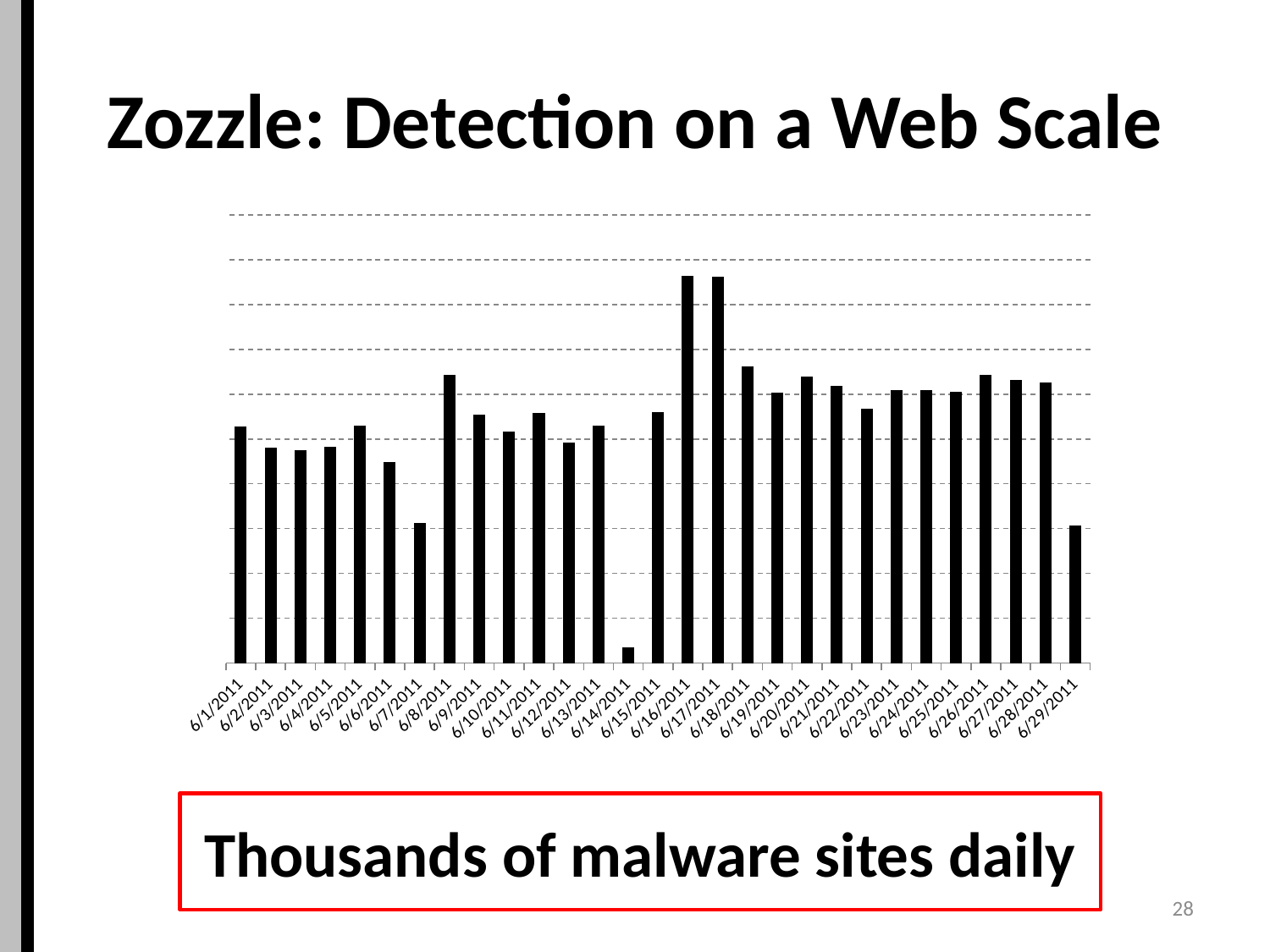
Which is larger, the value for 6/28/2011 or the value for 6/29/2011? 6/28/2011 What is the first date shown on the x axis of the chart? 6/1/2011 How many dates (bars) are plotted on the chart? 29 Which is larger, the value for 6/16/2011 or the value for 6/18/2011? 6/16/2011 What kind of chart is shown on the slide? bar chart Which is larger, the value for 6/1/2011 or the value for 6/7/2011? 6/1/2011 What is the title of the slide containing the chart? Zozzle: Detection on a Web Scale Which date has the lowest bar on the chart? 6/14/2011